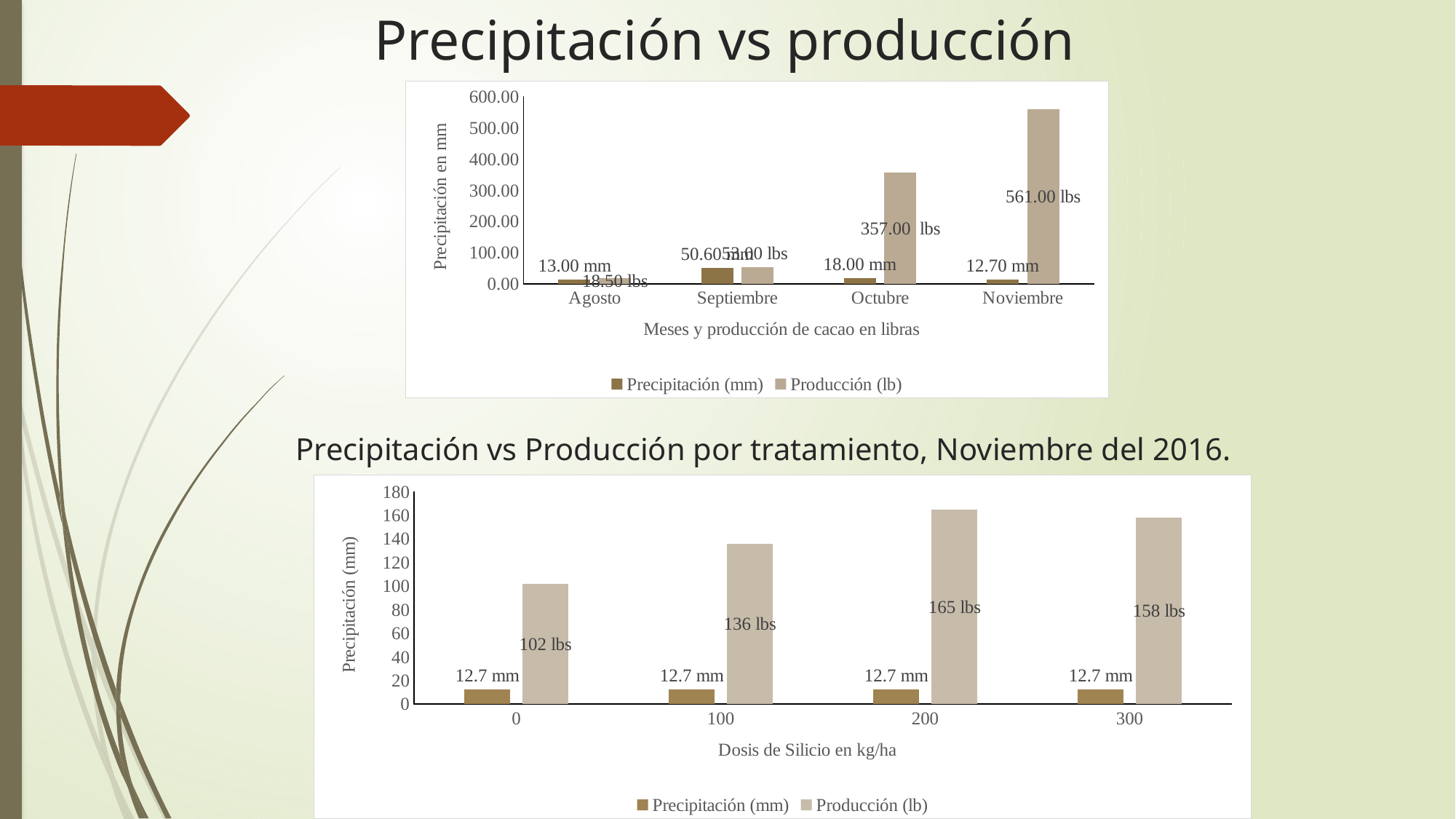
In the top chart, is the Producción (lb) value for Octubre greater or less than 300.00? greater In the bottom chart, what is the Producción (lb) value for a silicon dose of 200 kg/ha? 165 lbs In the top chart, what is the Producción (lb) value for Noviembre? 561.00 lbs What type of chart is the bottom chart? Bar chart In the top chart, how many months are shown on the x axis? 4 In the top chart, which month has the highest Producción (lb)? Noviembre In the top chart, what is the difference in Producción (lb) between Noviembre and Octubre? 204.00 lbs In the bottom chart, what is the difference in Producción (lb) between the 100 and 0 kg/ha doses? 34 lbs In the top chart, which month has the lowest Precipitación (mm)? Noviembre In the bottom chart, which silicon dose has the lowest Producción (lb)? 0 In the top chart, what is the Precipitación (mm) value for Agosto? 13.00 mm In the bottom chart, how many series does the legend list? 2